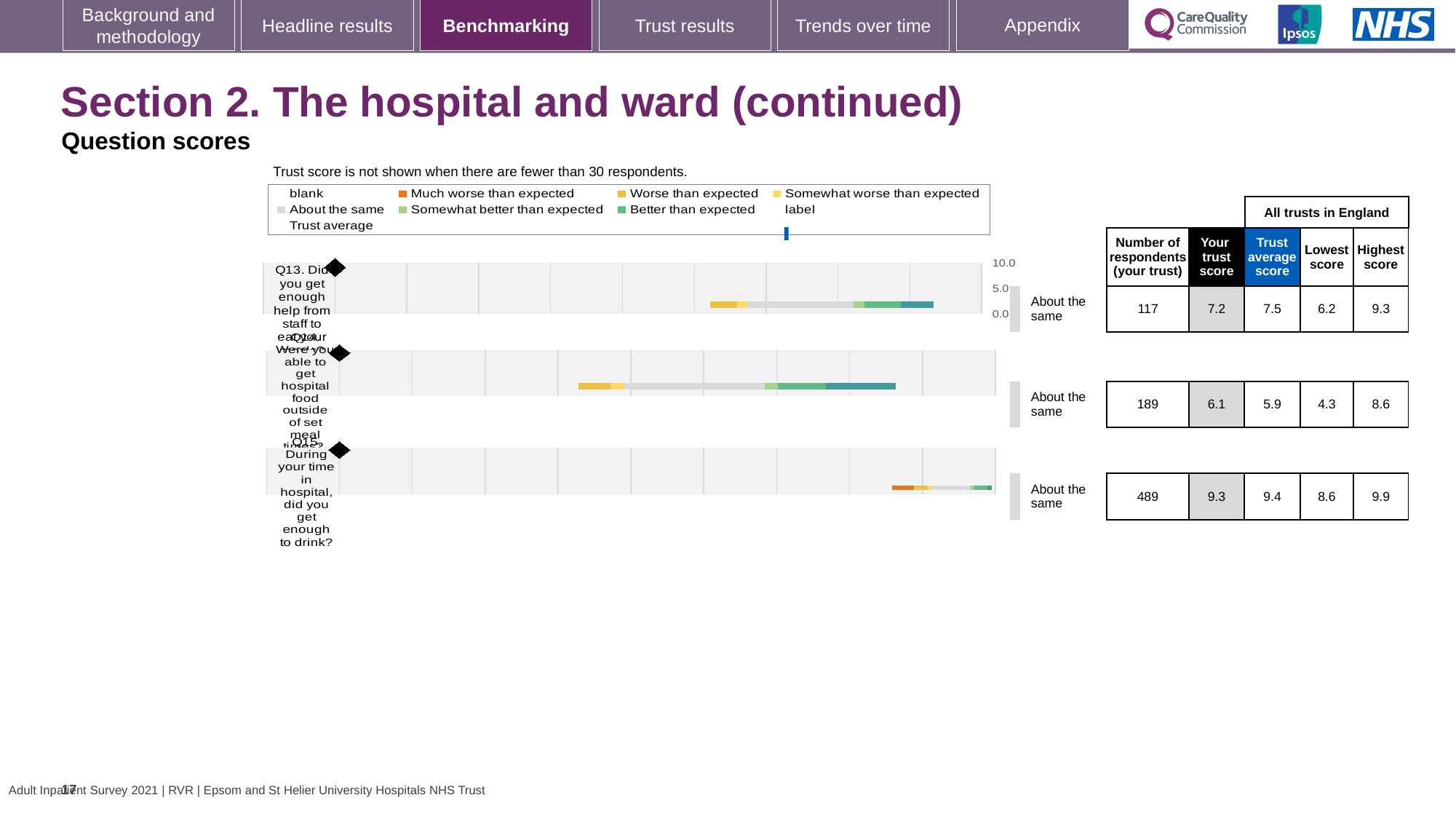
What is the lowest score across all trusts in England for Q15? 8.6 What is the 'Your trust score' for Q13 (Did you get enough help from staff to eat your meals?)? 7.2 For Q13, what is the difference between the trust average score and 'Your trust score'? 0.3 What benchmark category is shown next to the Q14 chart? About the same Which of the three questions shown has the fewest trust respondents? Q13 What is the trust average score across all trusts in England for Q15 (did you get enough to drink?)? 9.4 How many respondents from the trust answered Q14 (Were you able to get hospital food outside of set meal times?)? 189 How many question charts are shown on the slide? 3 What kind of chart is used to show the question scores? Bar chart For Q14, what is the difference between the highest score and the lowest score across all trusts in England? 4.3 For Q13, which is larger: 'Your trust score' or the trust average score? Trust average score Which of the three questions shown has the highest 'Your trust score'? Q15